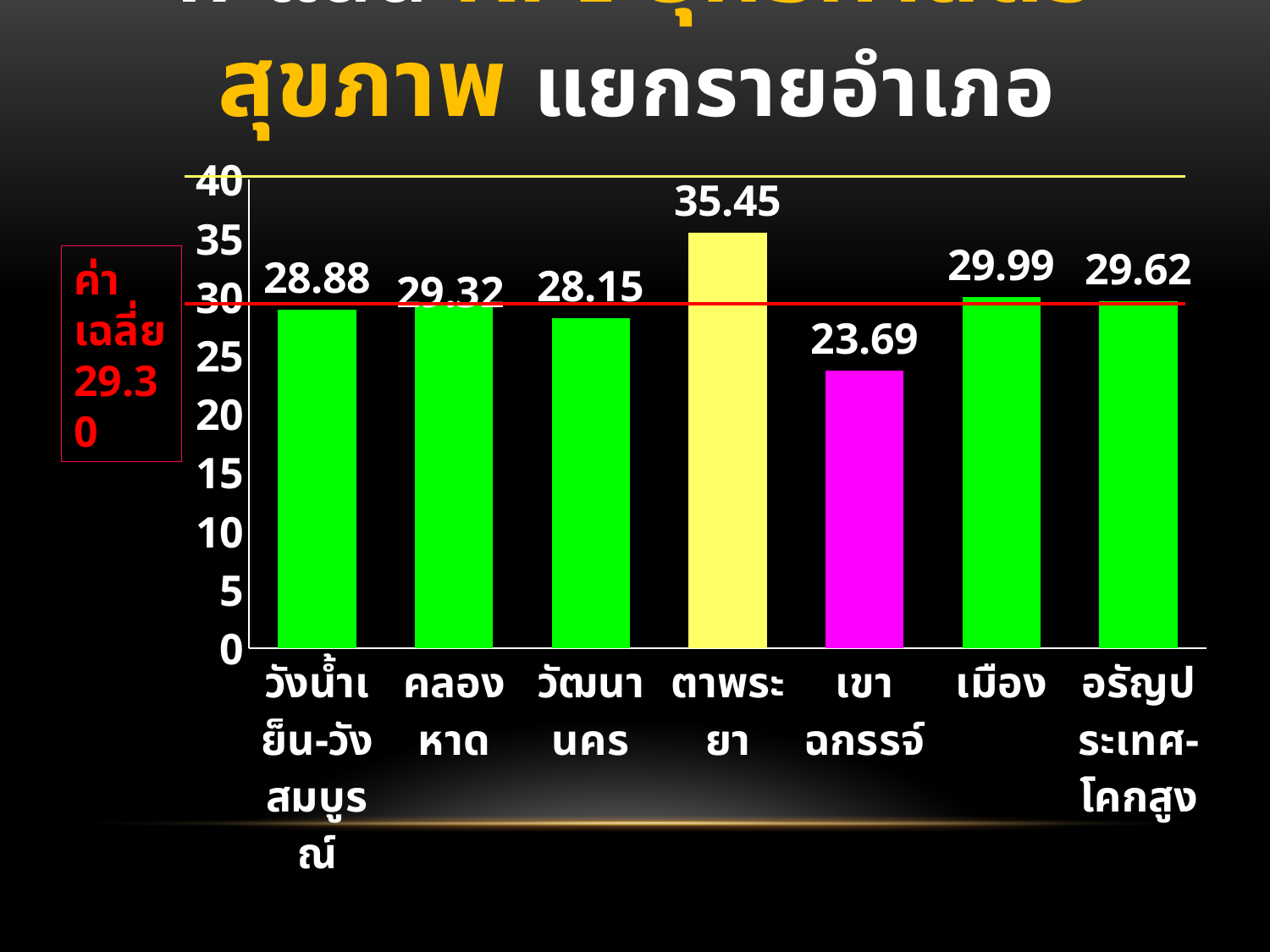
Is the value for ตาพระยา greater or less than 35? greater What is the value for ตาพระยา? 35.45 What is the difference between the values for ตาพระยา and เขาฉกรรจ์? 11.76 What average value (ค่าเฉลี่ย) is marked by the red line on the chart? 29.30 Which is larger, the value for คลองหาด or the value for วัฒนานคร? คลองหาด What kind of chart is shown on the slide? bar chart How many districts are shown on the chart? 7 What is the value for เขาฉกรรจ์? 23.69 Which district has the lowest value? เขาฉกรรจ์ What is the value for เมือง? 29.99 What is the value for วัฒนานคร? 28.15 Which district has the highest value? ตาพระยา